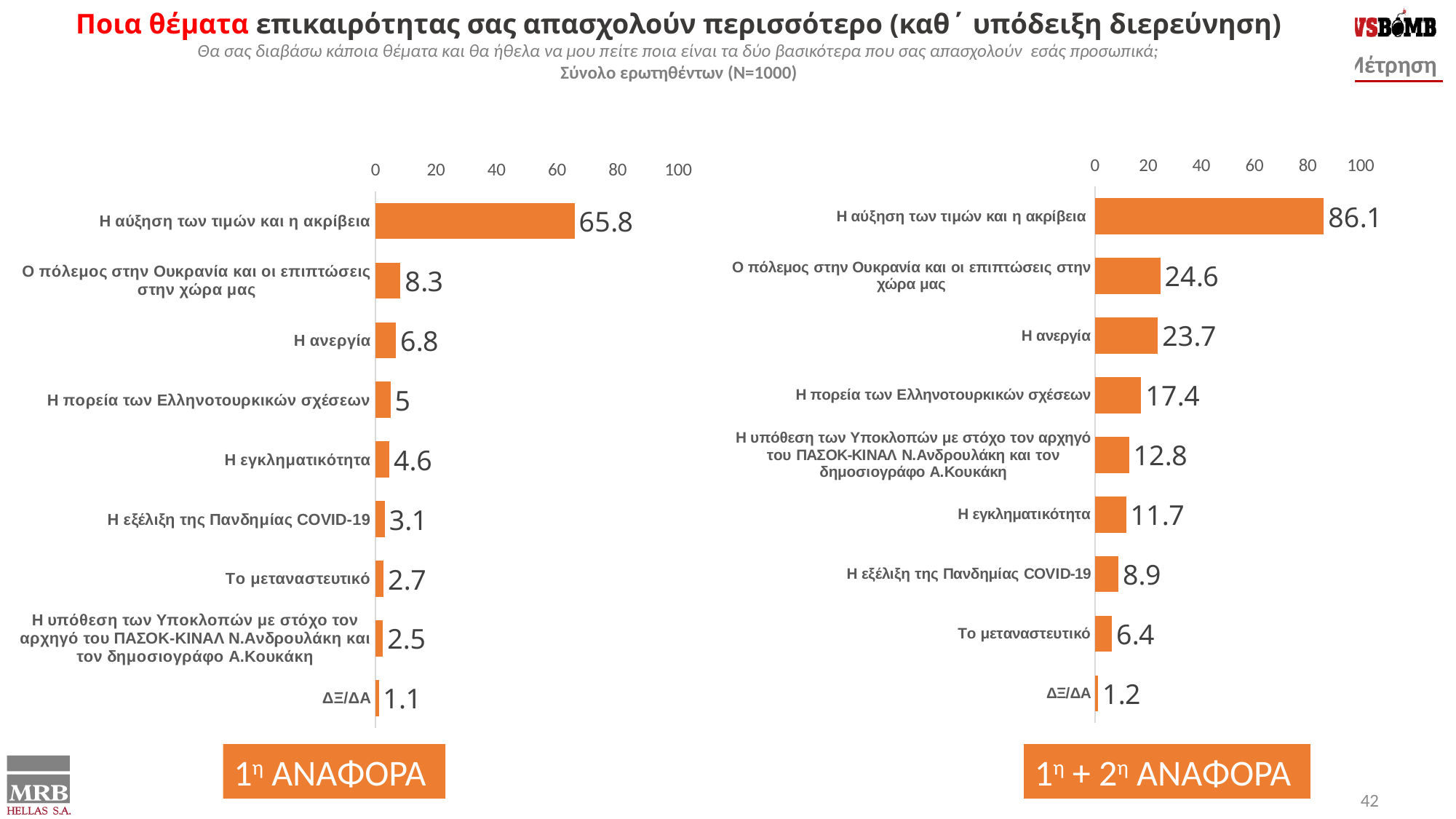
What is the label shown beneath the left chart? 1η ΑΝΑΦΟΡΑ In the left chart (1η ΑΝΑΦΟΡΑ), what is the difference between 'Η αύξηση των τιμών και η ακρίβεια' and 'Ο πόλεμος στην Ουκρανία και οι επιπτώσεις στην χώρα μας'? 57.5 In the left chart (1η ΑΝΑΦΟΡΑ), what is the value for 'Η αύξηση των τιμών και η ακρίβεια'? 65.8 How many categories are shown in the left chart (1η ΑΝΑΦΟΡΑ)? 9 In the right chart (1η + 2η ΑΝΑΦΟΡΑ), what is the value for 'Η υπόθεση των Υποκλοπών με στόχο τον αρχηγό του ΠΑΣΟΚ-ΚΙΝΑΛ Ν.Ανδρουλάκη και τον δημοσιογράφο Α.Κουκάκη'? 12.8 In the right chart (1η + 2η ΑΝΑΦΟΡΑ), which category has the highest value? Η αύξηση των τιμών και η ακρίβεια In the left chart (1η ΑΝΑΦΟΡΑ), which category has the lowest value? ΔΞ/ΔΑ In the right chart (1η + 2η ΑΝΑΦΟΡΑ), what is the difference between 'Ο πόλεμος στην Ουκρανία και οι επιπτώσεις στην χώρα μας' and 'Η ανεργία'? 0.9 In the left chart (1η ΑΝΑΦΟΡΑ), which is larger: 'Η εγκληματικότητα' or 'Η εξέλιξη της Πανδημίας COVID-19'? Η εγκληματικότητα In the right chart (1η + 2η ΑΝΑΦΟΡΑ), what is the value for 'Η ανεργία'? 23.7 What type of chart is the right chart (1η + 2η ΑΝΑΦΟΡΑ)? Bar chart In the right chart (1η + 2η ΑΝΑΦΟΡΑ), is the value for 'Η αύξηση των τιμών και η ακρίβεια' greater or less than 80? greater